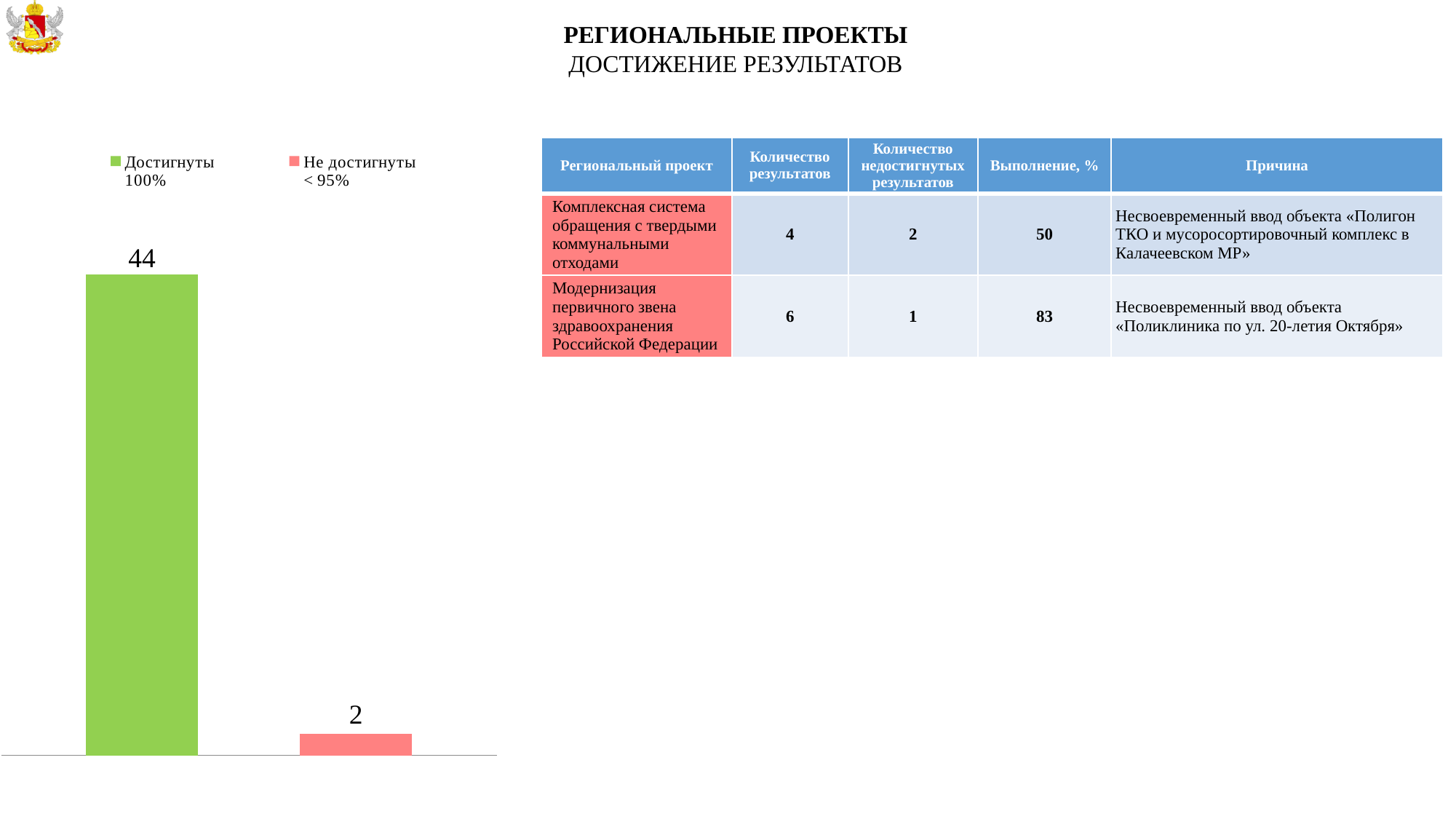
What is the value of the red bar labelled 'Не достигнуты < 95%'? 2 What kind of chart is shown on the slide? Bar chart Which series has the lowest value in the chart? Не достигнуты < 95% What is the total of the two bar values in the chart? 46 Which series has the higher value, 'Достигнуты 100%' or 'Не достигнуты < 95%'? Достигнуты 100% Is the value for 'Достигнуты 100%' larger than the value for 'Не достигнуты < 95%'? Yes What colour is the bar for 'Не достигнуты < 95%'? Red How many series does the chart legend list? 2 How many bars are plotted in the chart? 2 What is the difference between the 'Достигнуты 100%' value and the 'Не достигнуты < 95%' value? 42 What is the value of the green bar labelled 'Достигнуты 100%'? 44 What colour is the bar for 'Достигнуты 100%'? Green